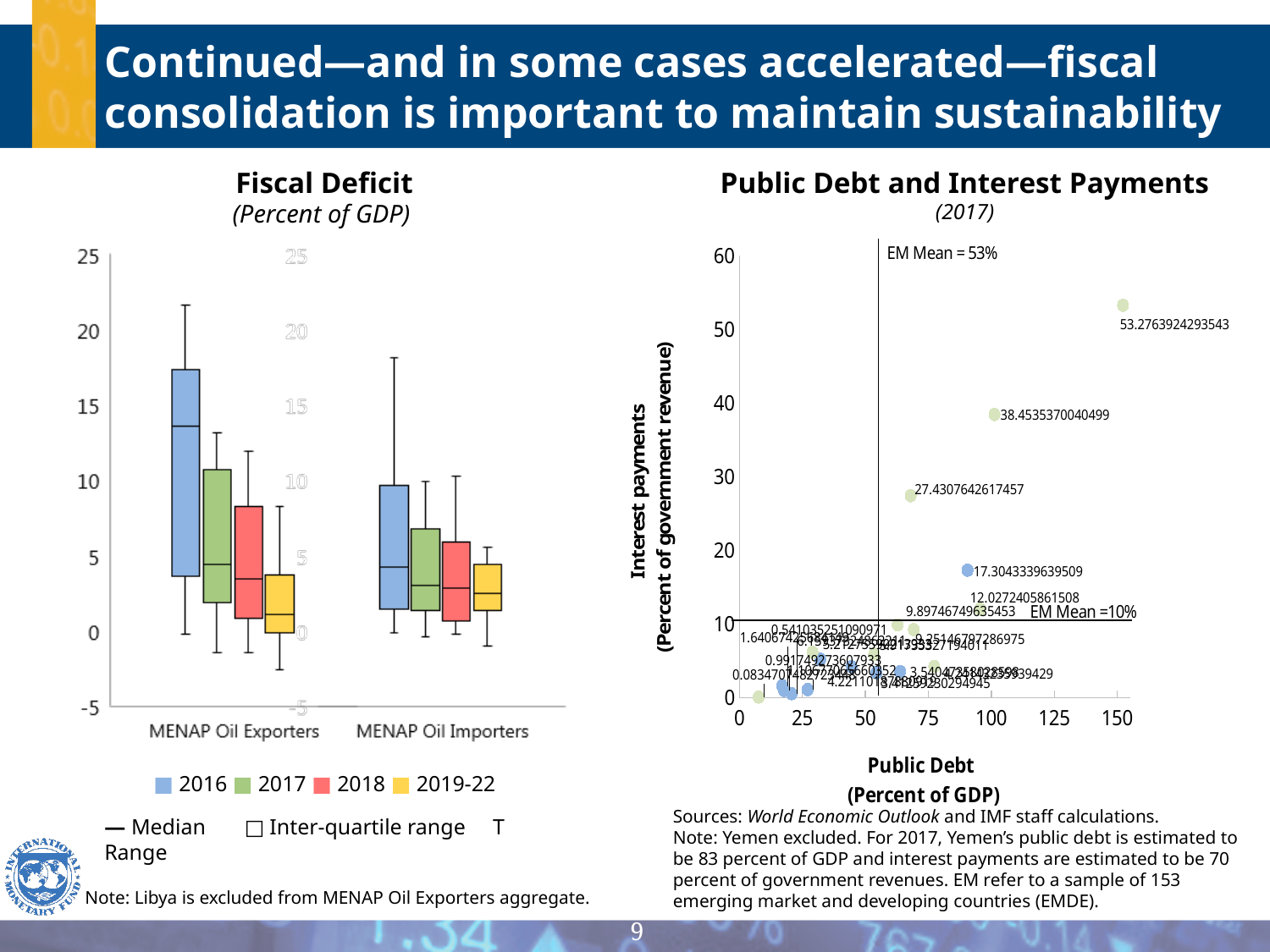
In the Public Debt and Interest Payments chart, is the public debt of the point labelled 53.2763924293543 greater or less than 125? greater In the Fiscal Deficit chart, is the 2016 median for MENAP Oil Exporters greater or less than 10? greater In the Fiscal Deficit chart, how many categories are shown on the x axis? 2 In the Fiscal Deficit chart, how many series does the legend list? 4 What kind of chart is the Fiscal Deficit chart on the left? Box plot In the Public Debt and Interest Payments chart, what is the highest interest payments value labelled? 53.2763924293543 What kind of chart is the Public Debt and Interest Payments chart on the right? Scatter chart In the Fiscal Deficit chart, is the 2019-22 median for MENAP Oil Exporters greater or less than 5? less In the Public Debt and Interest Payments chart, what is the EM Mean for public debt shown by the vertical line? 53% In the Fiscal Deficit chart, do the medians for MENAP Oil Exporters rise or fall from 2016 to 2019-22? fall In the Fiscal Deficit chart, which category has the larger 2016 median, MENAP Oil Exporters or MENAP Oil Importers? MENAP Oil Exporters In the Public Debt and Interest Payments chart, what is the EM Mean for interest payments shown by the horizontal line? 10%